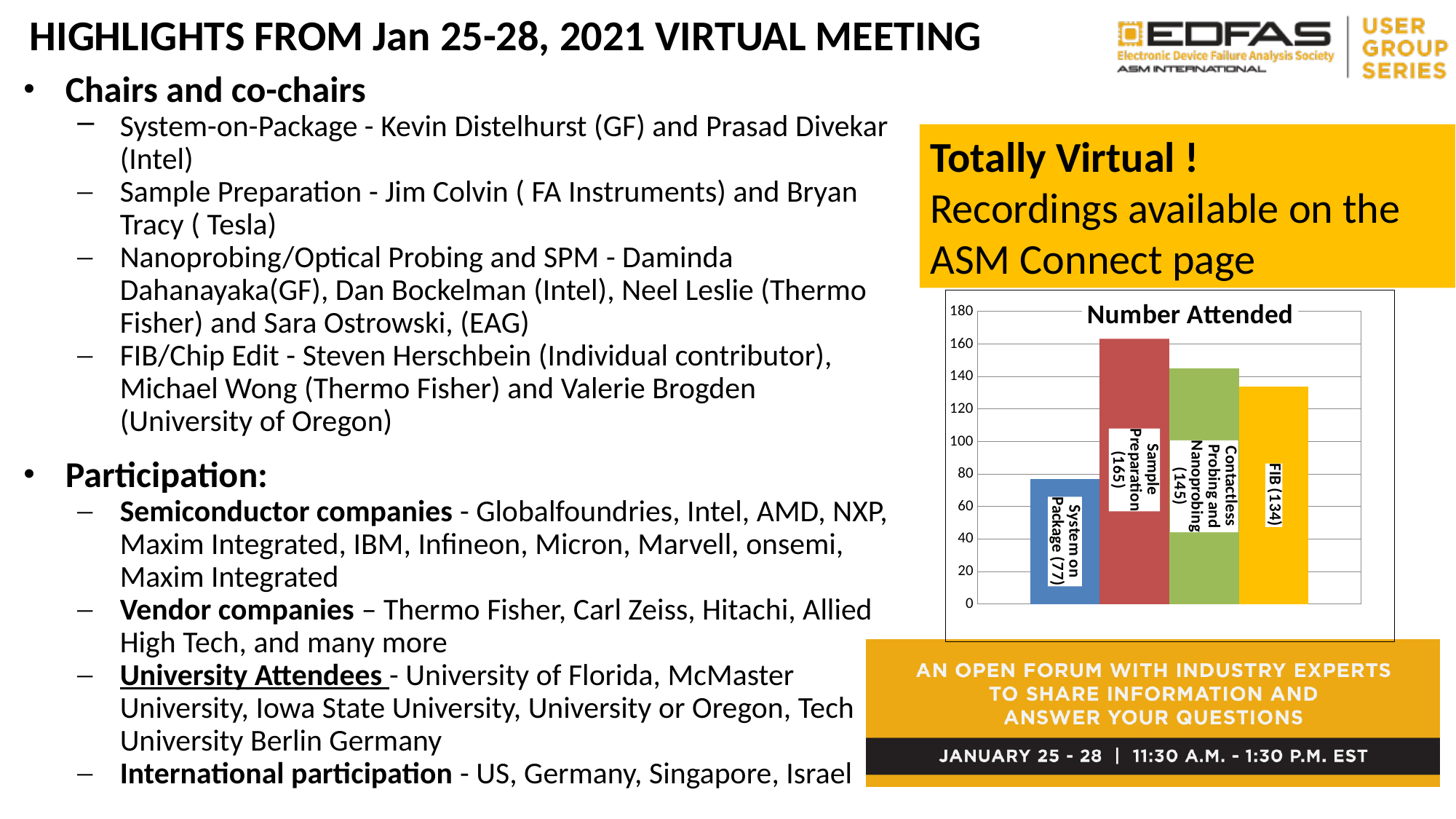
What is the difference in attendance between Sample Preparation and System on Package? 88 Which category had the highest number attended? Sample Preparation What kind of chart is shown on the slide? bar chart Is the number attended for Contactless Probing and Nanoprobing greater or less than 140? greater What is the number attended for FIB? 134 Which had more attendees, Contactless Probing and Nanoprobing or FIB? Contactless Probing and Nanoprobing Which category had the lowest number attended? System on Package What is the number attended for System on Package? 77 How many people attended the Sample Preparation session? 165 How many categories are plotted in the Number Attended chart? 4 What is the title of the chart? Number Attended What colour is the bar for FIB? yellow